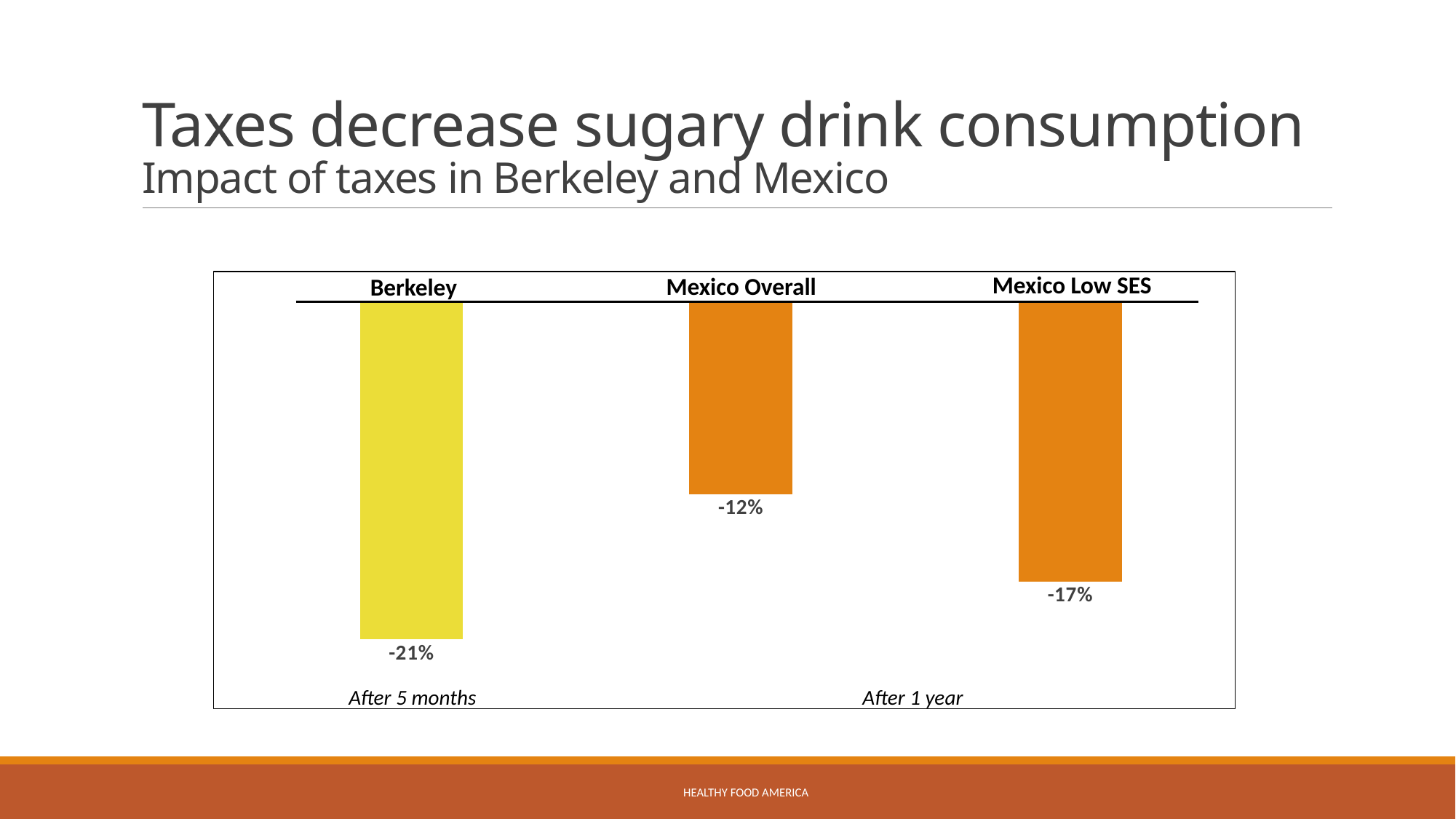
What is the value for Mexico Low SES? -17% Which category shows the largest decrease? Berkeley What kind of chart is shown on the slide? Bar chart What colour is the Berkeley bar? Yellow What is the difference between the Berkeley value and the Mexico Overall value? 9 percentage points Which category shows the smallest decrease? Mexico Overall What is the value for Berkeley? -21% What is the difference between the Mexico Low SES value and the Mexico Overall value? 5 percentage points What time period label appears under the Berkeley bar? After 5 months What is the value for Mexico Overall? -12% Which shows a larger decrease, Mexico Low SES or Mexico Overall? Mexico Low SES How many categories are plotted in the chart? 3